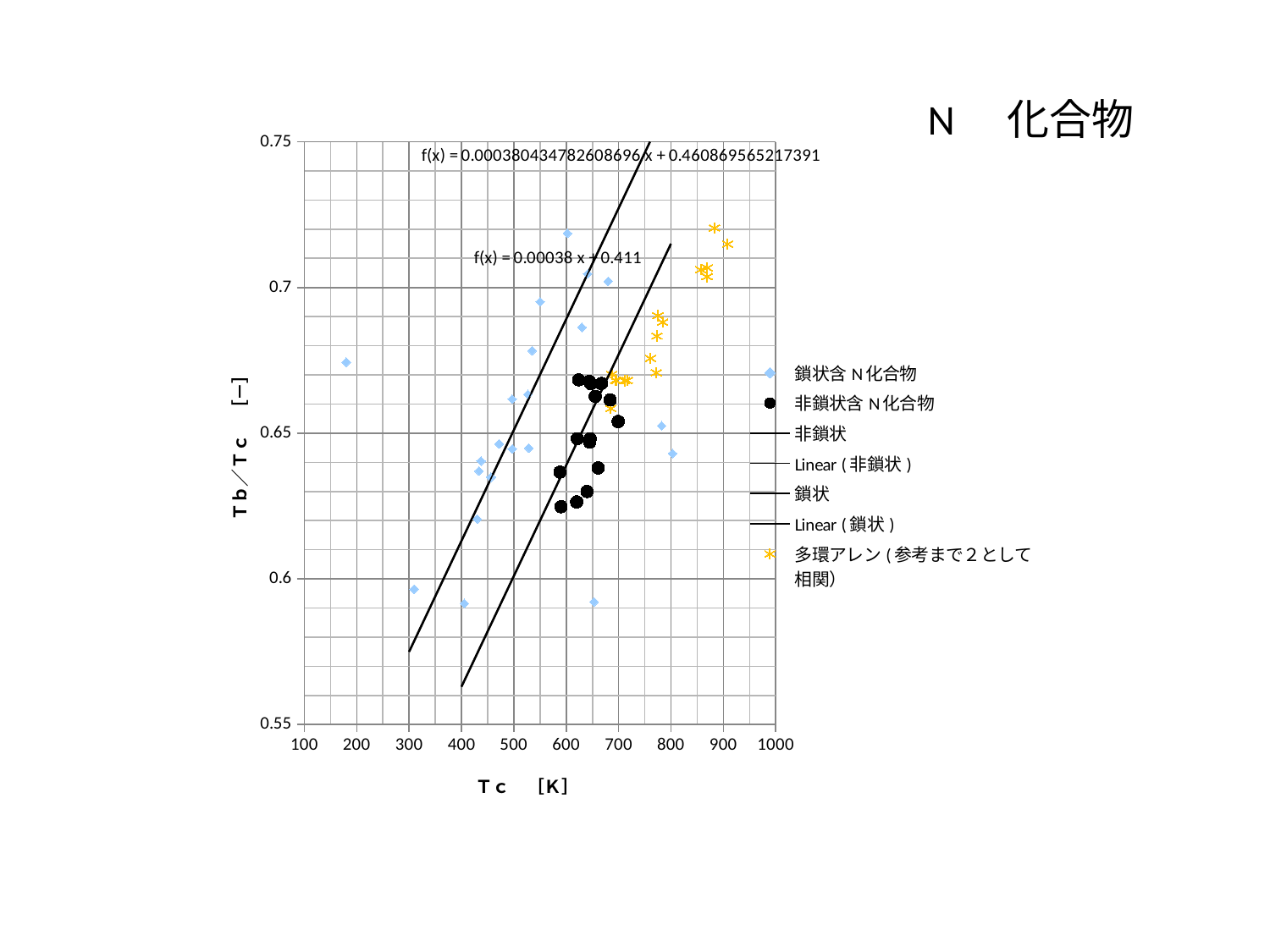
Do the two fitted lines rise or fall as Tc increases? rise What is the intercept in the trendline equation f(x) = 0.000380434782608696x + ...? 0.460869565217391 Is the Tb/Tc value of the lowest 非鎖状含N化合物 point greater or less than 0.65? less How many entries does the chart legend list? 7 Is the Tb/Tc value of the highest 多環アレン point greater or less than 0.7? greater What kind of chart is shown on the slide? scatter chart What is the minimum value shown on the x axis? 100 What is the label of the x axis? Tc [K] What is the title of the chart? N 化合物 What is the maximum value shown on the y axis? 0.75 Is the Tb/Tc value of the leftmost 鎖状含N化合物 point (near Tc = 200) greater or less than 0.65? greater